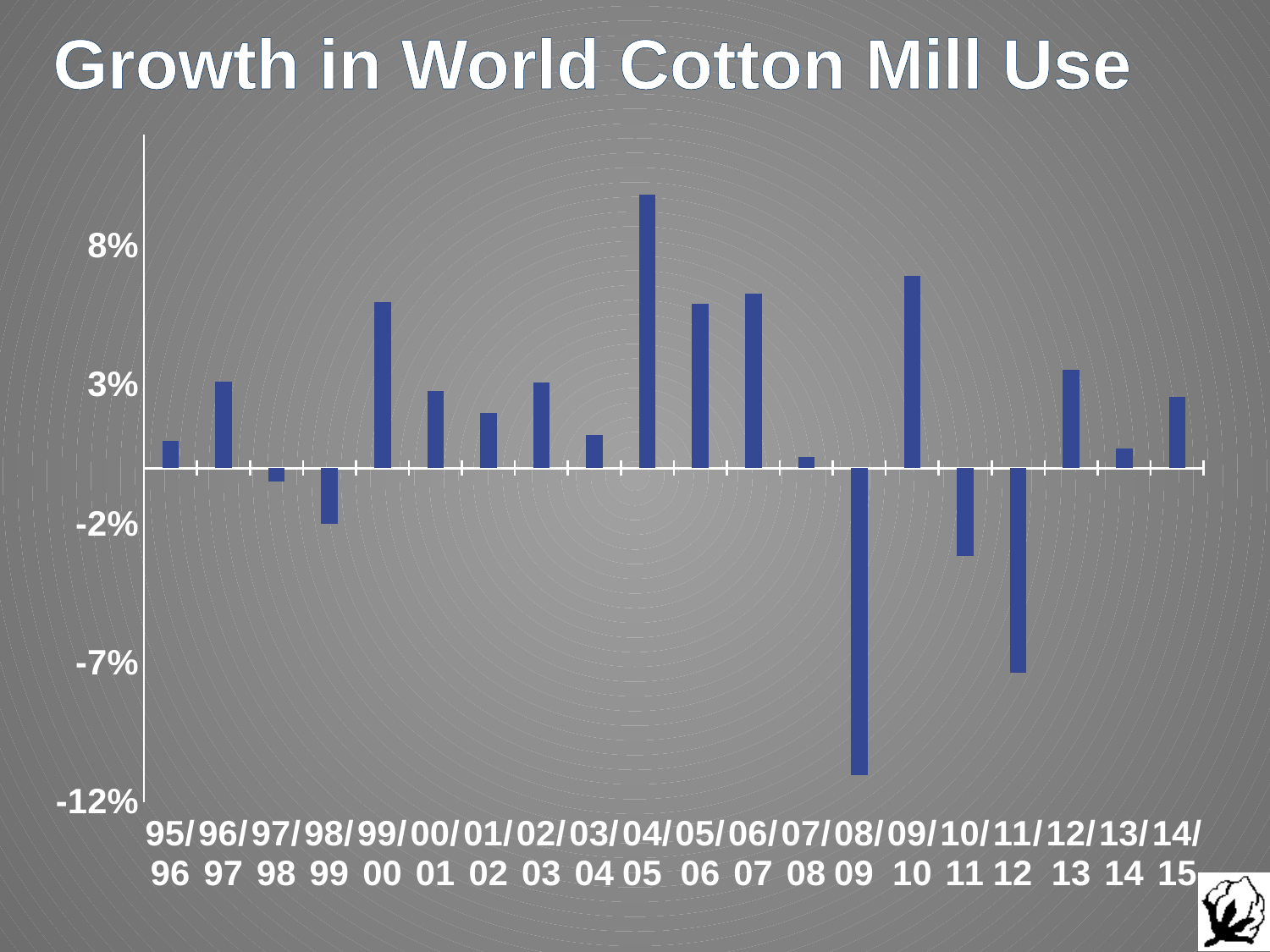
How many seasons show negative growth (bars below the zero line)? 5 Is the value for 08/09 greater or less than -7%? less What is the title of the chart? Growth in World Cotton Mill Use Which season has the highest growth in world cotton mill use? 04/05 Which season has the lowest growth in world cotton mill use? 08/09 Is the value for 04/05 greater or less than 8%? greater What kind of chart is shown on the slide? bar chart Which season has the larger value, 10/11 or 12/13? 12/13 Is the value for 99/00 greater or less than 3%? greater How many seasons (categories) are plotted on the x axis? 20 Which season has the larger value, 04/05 or 09/10? 04/05